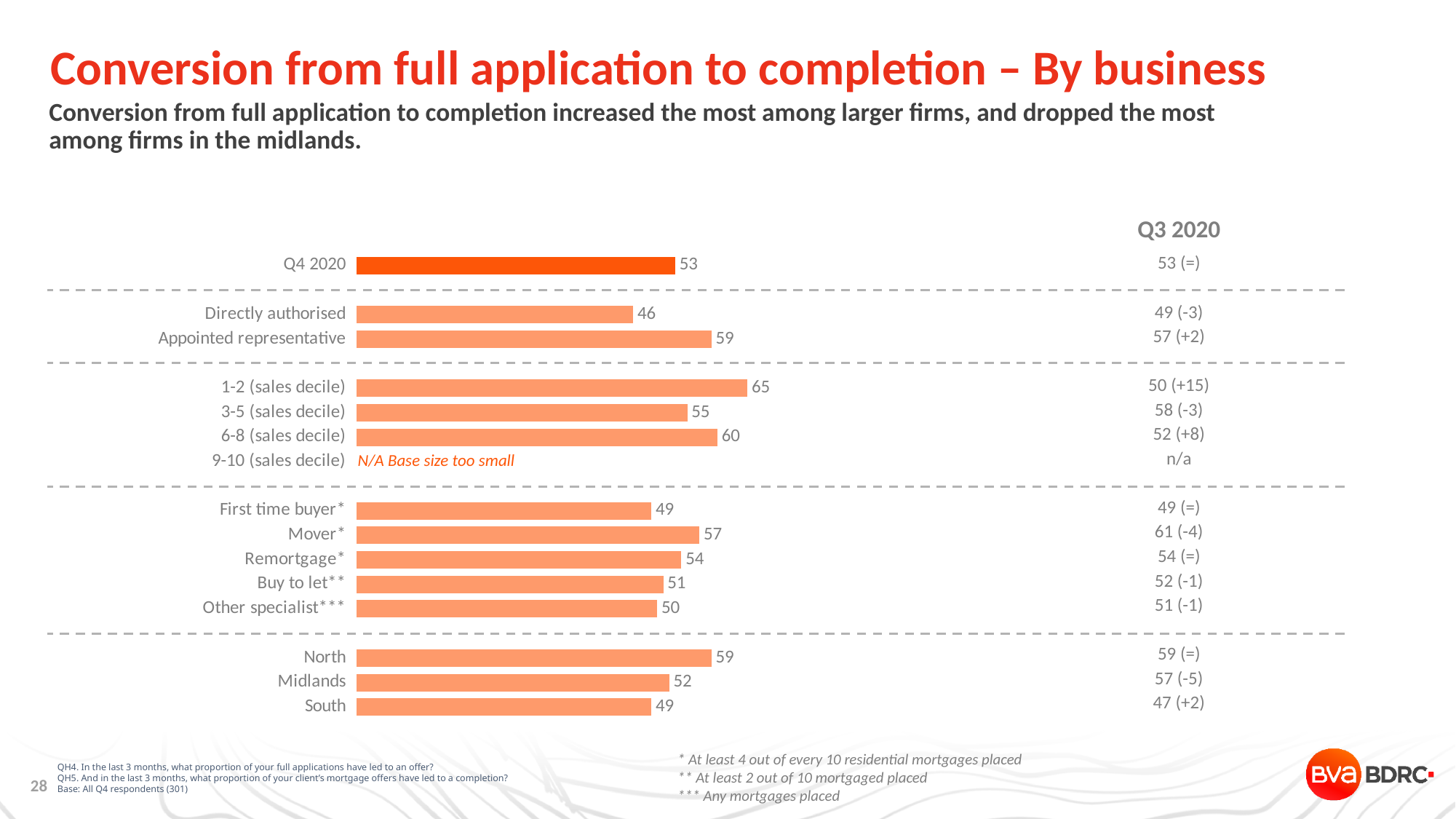
Which category has the lowest value on the chart? Directly authorised What is shown for 9-10 (sales decile) instead of a bar? N/A Base size too small What is the difference between the values for Appointed representative and Directly authorised? 13 What is the value for Appointed representative? 59 What is the value for Q4 2020 overall? 53 How many bars are plotted on the chart? 14 Which is larger, the value for Mover or the value for First time buyer? Mover What is the difference between the values for North and South? 10 Which category has the highest value on the chart? 1-2 (sales decile) What kind of chart is shown on the slide? Bar chart What is the value for 6-8 (sales decile)? 60 What is the value for Midlands? 52